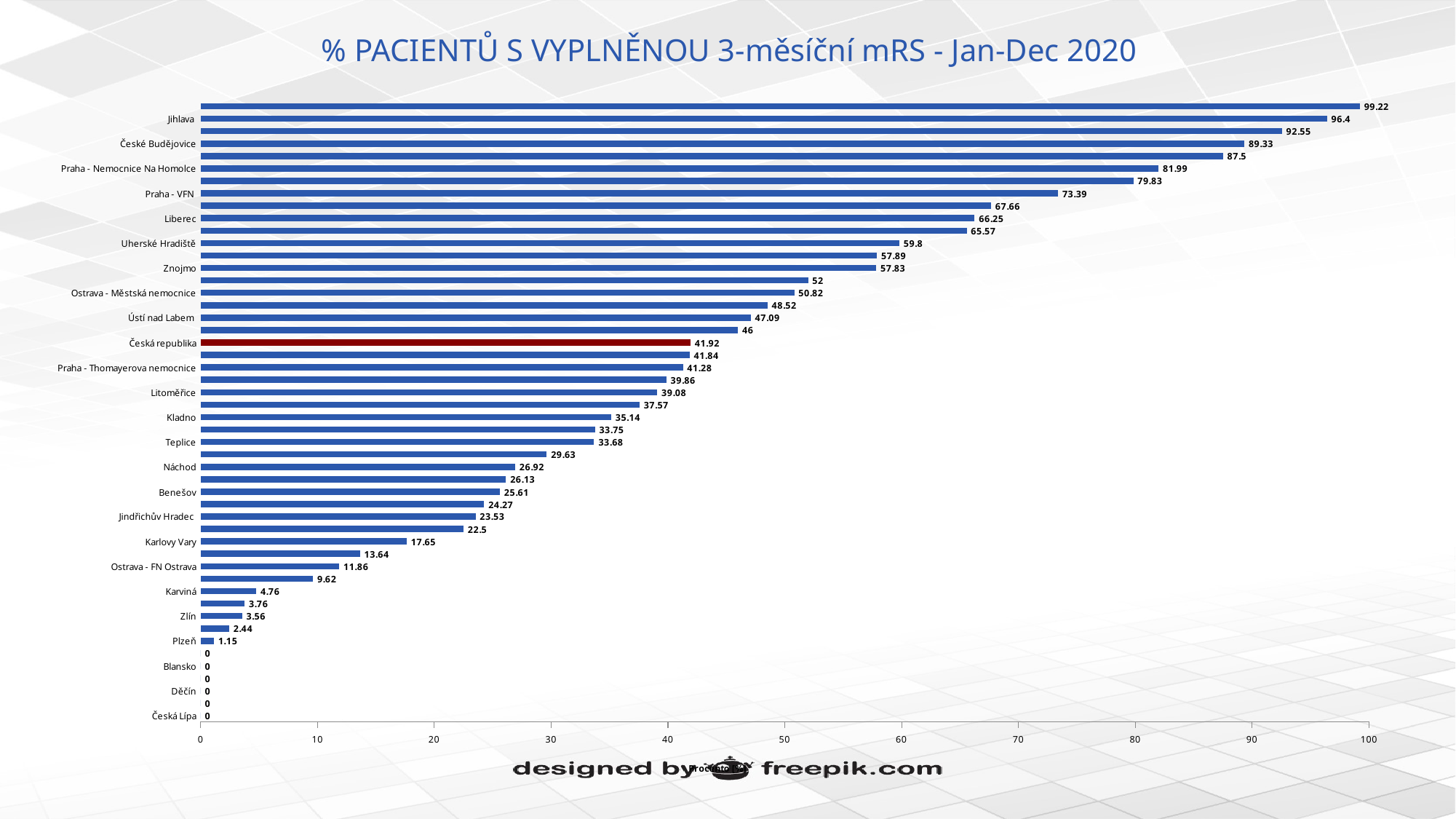
What is the difference between the values for Liberec and Kladno? 31.11 Which has a larger value, Znojmo or Teplice? Znojmo What is the value for Děčín? 0 What is the value for Karlovy Vary? 17.65 What is the title of the chart? % PACIENTŮ S VYPLNĚNOU 3-měsíční mRS - Jan-Dec 2020 What is the value for Česká republika? 41.92 Which category's bar is coloured red instead of blue? Česká republika What is the value for Praha - VFN? 73.39 What kind of chart is shown on the slide? bar chart What is the value for Jihlava? 96.4 What is the value for Plzeň? 1.15 What is the highest value shown on the chart? 99.22